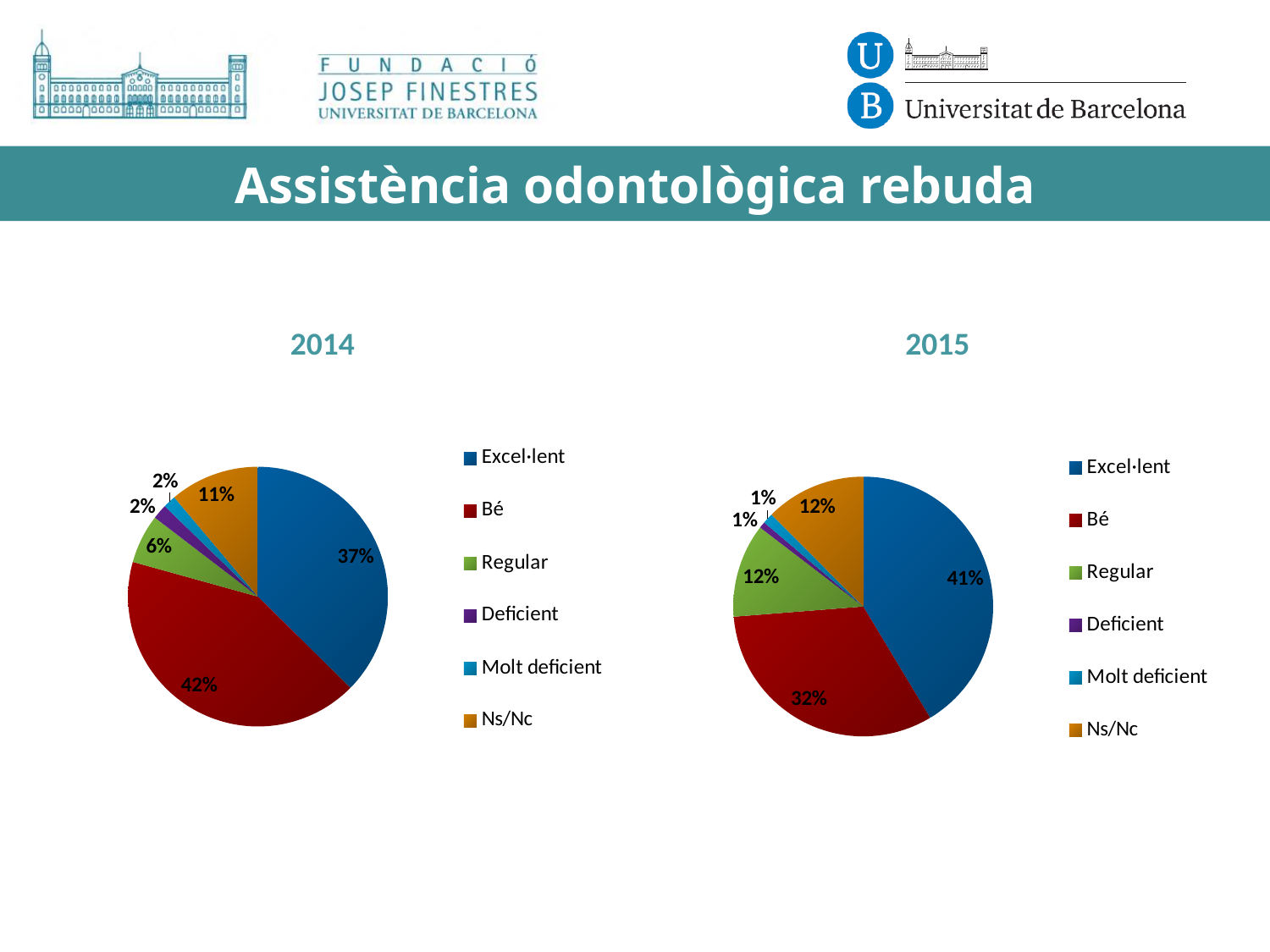
In the 2015 pie chart, what share is labelled for Regular? 12% In the 2014 pie chart, what is the difference between the Regular and Ns/Nc shares? 5% In the 2014 pie chart, which category has the largest slice? Bé In the 2014 pie chart, what share is labelled for Bé? 42% What type of chart is used for the 2014 data? Pie chart In the 2014 pie chart, which is larger, Excel·lent or Bé? Bé In the 2015 pie chart, what share is labelled for Excel·lent? 41% How many categories does the legend of the 2015 pie chart list? 6 In the 2014 pie chart, what share is labelled for Ns/Nc? 11% In the 2015 pie chart, which category has the largest slice? Excel·lent In the 2015 pie chart, what is the difference between the Excel·lent and Bé shares? 9% In the 2015 pie chart, which is larger, Excel·lent or Bé? Excel·lent